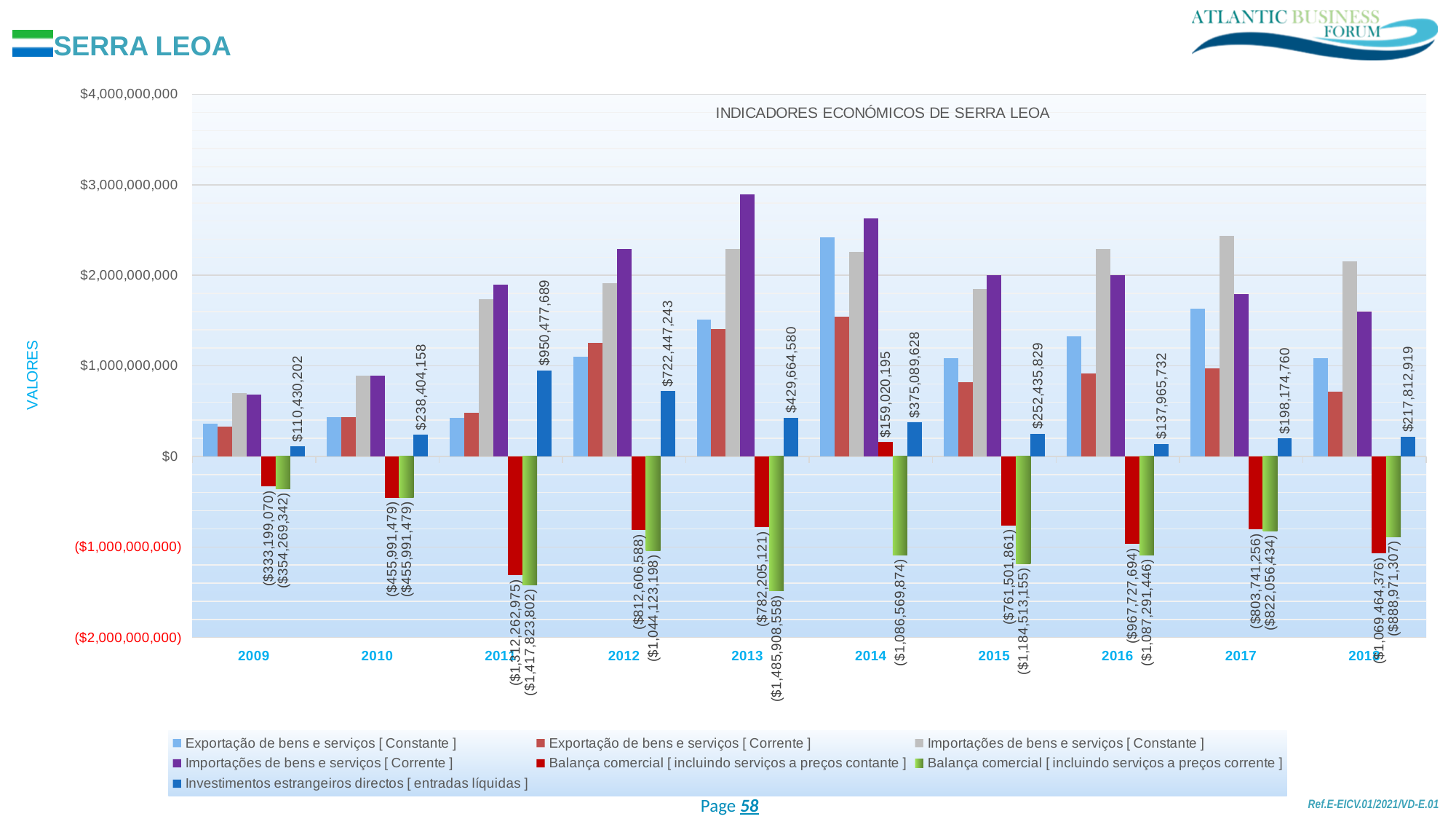
What is the value of Balança comercial [ incluindo serviços a preços corrente ] in 2013? ($1,485,908,558) How many years are shown on the x axis? 10 In which year is Investimentos estrangeiros directos [ entradas líquidas ] lowest? 2009 How many series does the legend list? 7 In which year is Investimentos estrangeiros directos [ entradas líquidas ] highest? 2011 What is the title of the chart? INDICADORES ECONÓMICOS DE SERRA LEOA What is the value of Balança comercial [ incluindo serviços a preços contante ] in 2014? $159,020,195 What is the difference between Investimentos estrangeiros directos in 2011 and in 2012? $228,030,446 What is the value of Investimentos estrangeiros directos [ entradas líquidas ] in 2011? $950,477,689 What kind of chart is shown on the slide? Bar chart Is the value for Importações de bens e serviços [ Corrente ] in 2013 greater or less than $2,000,000,000? greater Which year has the larger value for Investimentos estrangeiros directos [ entradas líquidas ], 2017 or 2018? 2018